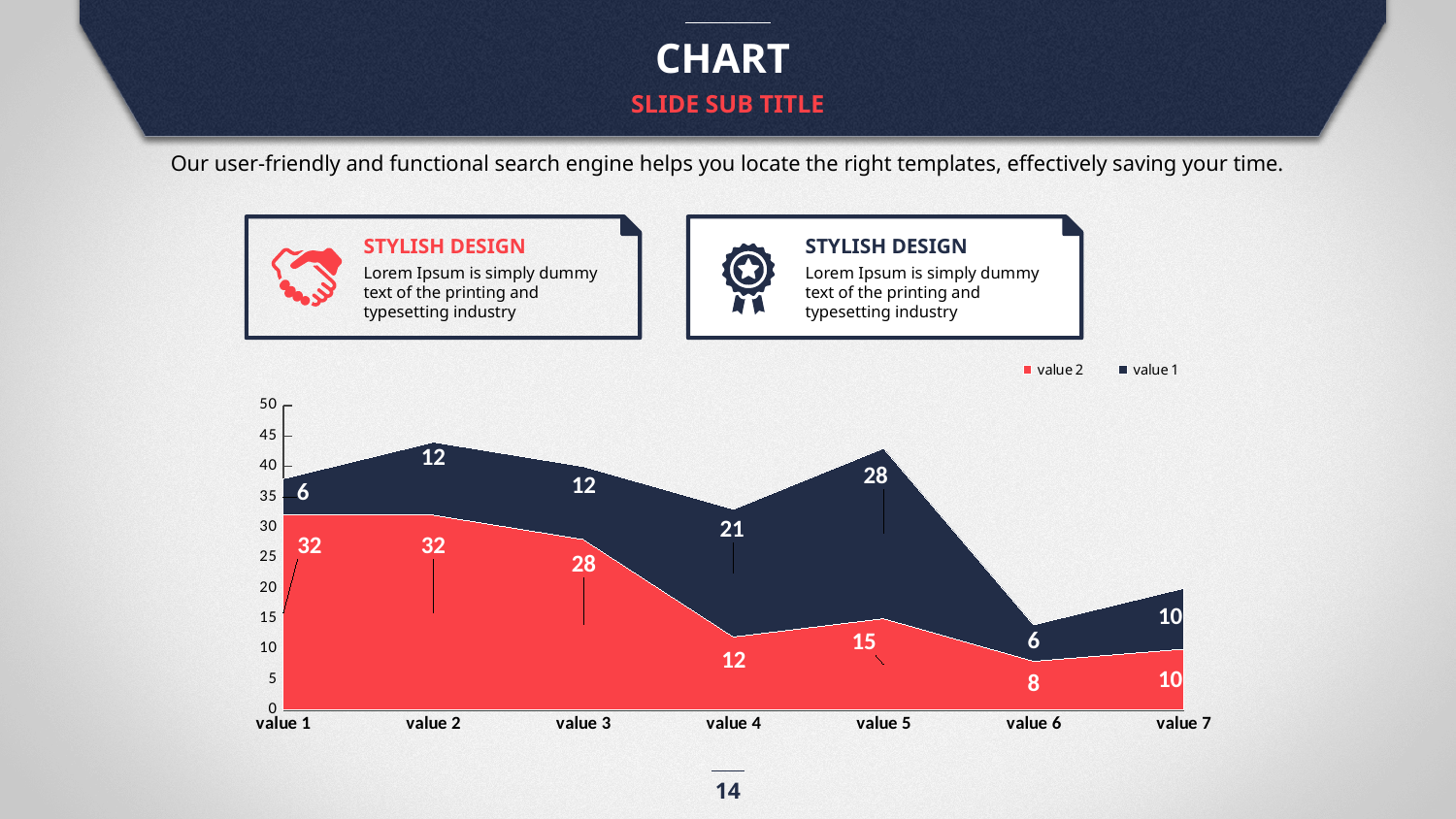
What kind of chart is shown on the slide? Stacked area chart What is the value of the 'value 1' series at value 5? 28 At which category does the 'value 1' series reach its highest value? value 5 How many series does the legend list? 2 How many categories are shown on the x axis? 7 What is the value of the 'value 2' series at value 1? 32 What is the combined total of the two series at value 2? 44 Which is larger at value 5: the 'value 1' series or the 'value 2' series? value 1 What is the difference between the 'value 2' series at value 3 and at value 4? 16 At which category is the 'value 2' series lowest? value 6 What is the value of the 'value 2' series at value 6? 8 What is the value of the 'value 1' series at value 4? 21